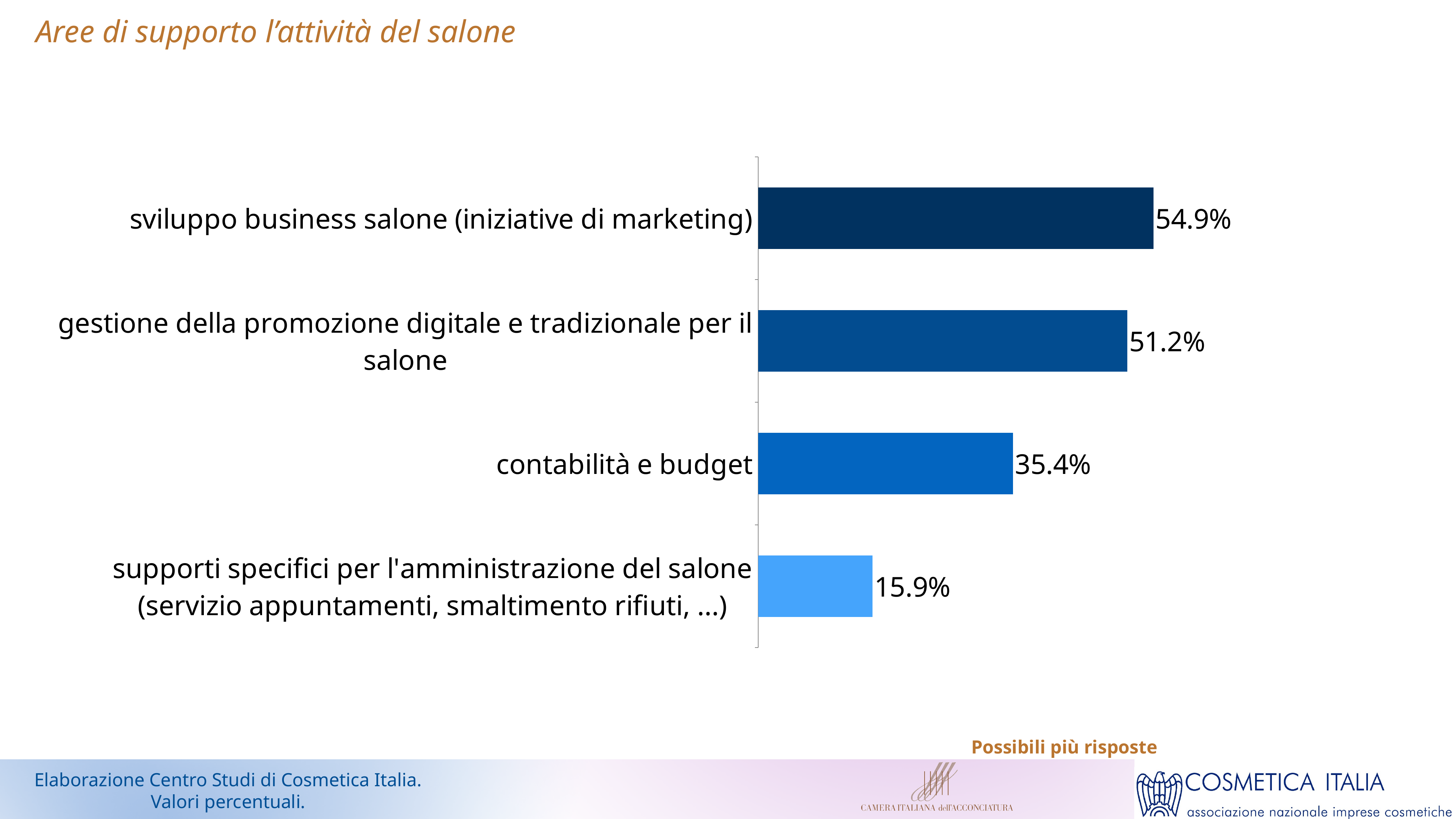
What is the title of the slide? Aree di supporto l'attività del salone What is the difference between the values for 'contabilità e budget' and 'supporti specifici per l'amministrazione del salone'? 19.5% Which category has the highest value? sviluppo business salone (iniziative di marketing) What is the value for 'sviluppo business salone (iniziative di marketing)'? 54.9% What is the value for 'contabilità e budget'? 35.4% What kind of chart is shown on the slide? bar chart What is the value for 'supporti specifici per l'amministrazione del salone (servizio appuntamenti, smaltimento rifiuti, ...)'? 15.9% What is the difference between the values for 'sviluppo business salone (iniziative di marketing)' and 'gestione della promozione digitale e tradizionale per il salone'? 3.7% Which is larger: the value for 'contabilità e budget' or the value for 'gestione della promozione digitale e tradizionale per il salone'? gestione della promozione digitale e tradizionale per il salone What is the value for 'gestione della promozione digitale e tradizionale per il salone'? 51.2% How many categories are shown in the chart? 4 Which category has the lowest value? supporti specifici per l'amministrazione del salone (servizio appuntamenti, smaltimento rifiuti, ...)